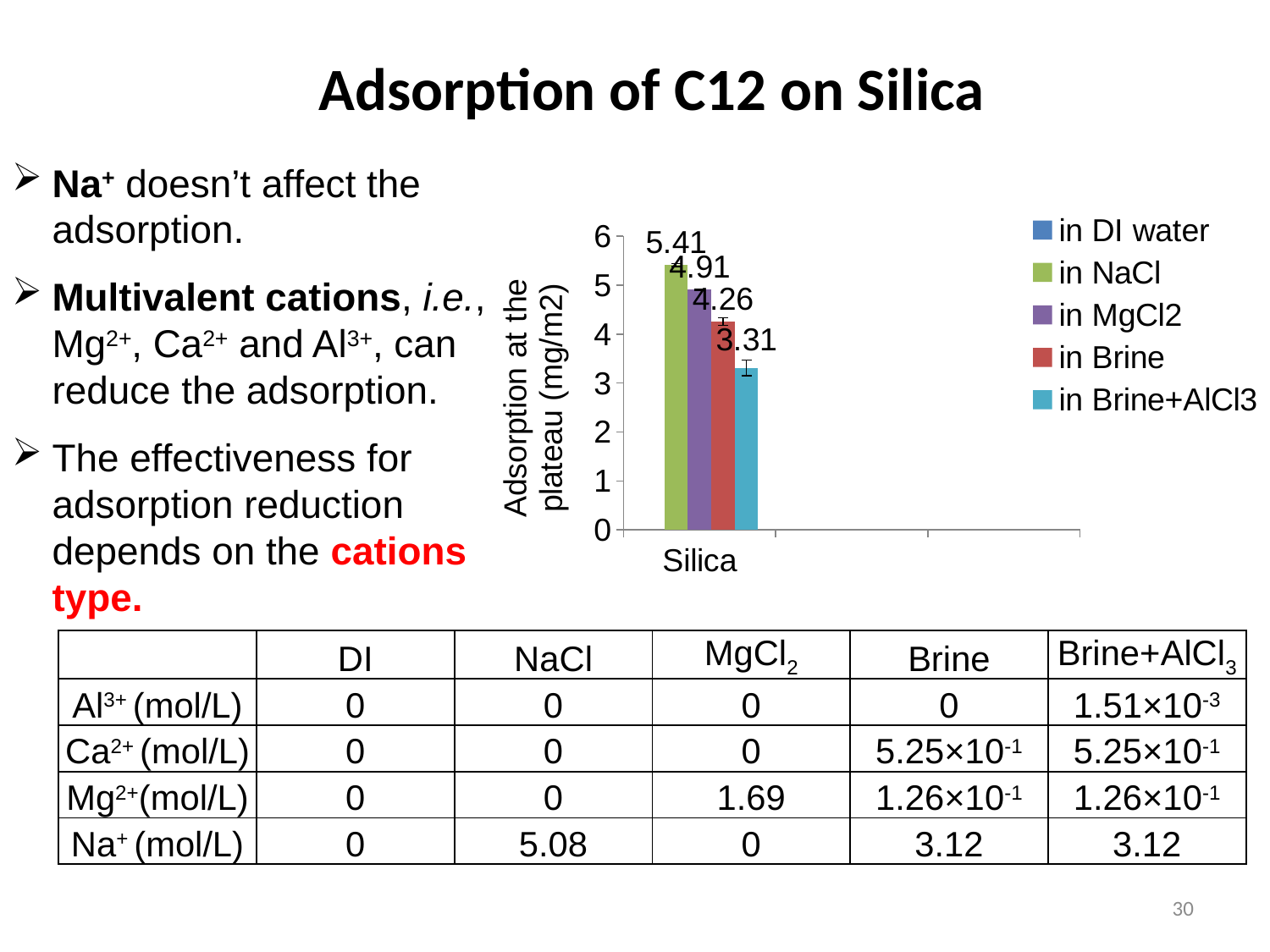
What is the adsorption value for the 'in MgCl2' series? 4.91 Which series has the lowest adsorption value in the chart? in Brine+AlCl3 What is the adsorption value for the 'in NaCl' series? 5.41 Which is larger, the adsorption in Brine or in Brine+AlCl3? in Brine What is the title of the chart's y axis? Adsorption at the plateau (mg/m2) What is the adsorption value for the 'in Brine+AlCl3' series? 3.31 What is the label of the category shown on the x axis of the chart? Silica What is the adsorption value for the 'in Brine' series? 4.26 What is the difference between the adsorption in Brine and in Brine+AlCl3? 0.95 What kind of chart is shown on the slide? bar chart Is the adsorption value for 'in Brine+AlCl3' greater or less than 4? less How many series does the chart legend list? 5